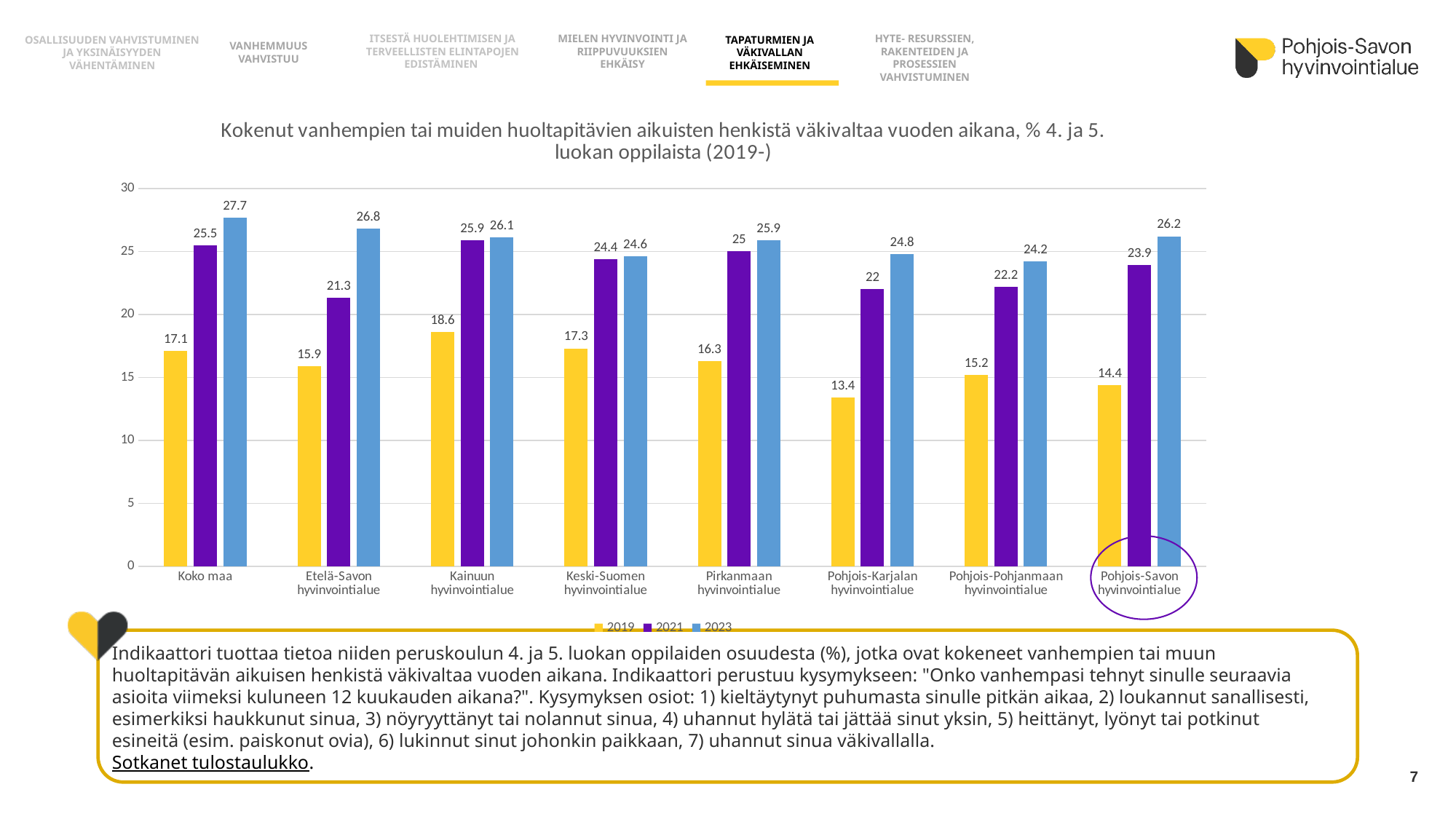
What is the difference between the 2023 and 2019 values for Pohjois-Savon hyvinvointialue? 11.8 Which is larger, the 2019 value for Kainuun hyvinvointialue or the 2019 value for Koko maa? Kainuun hyvinvointialue What is the value for Koko maa in 2019? 17.1 What is the value for Pohjois-Karjalan hyvinvointialue in 2021? 22 Which category has the highest value in the 2019 series? Kainuun hyvinvointialue What kind of chart is shown on the slide? bar chart Is the 2021 value for Etelä-Savon hyvinvointialue greater or less than 20? greater Which category has the lowest value in the 2019 series? Pohjois-Karjalan hyvinvointialue What is the value for Pohjois-Savon hyvinvointialue in 2023? 26.2 Which category has the highest value in the 2023 series? Koko maa How many categories (areas) are shown on the x axis? 8 How many series does the legend list? 3